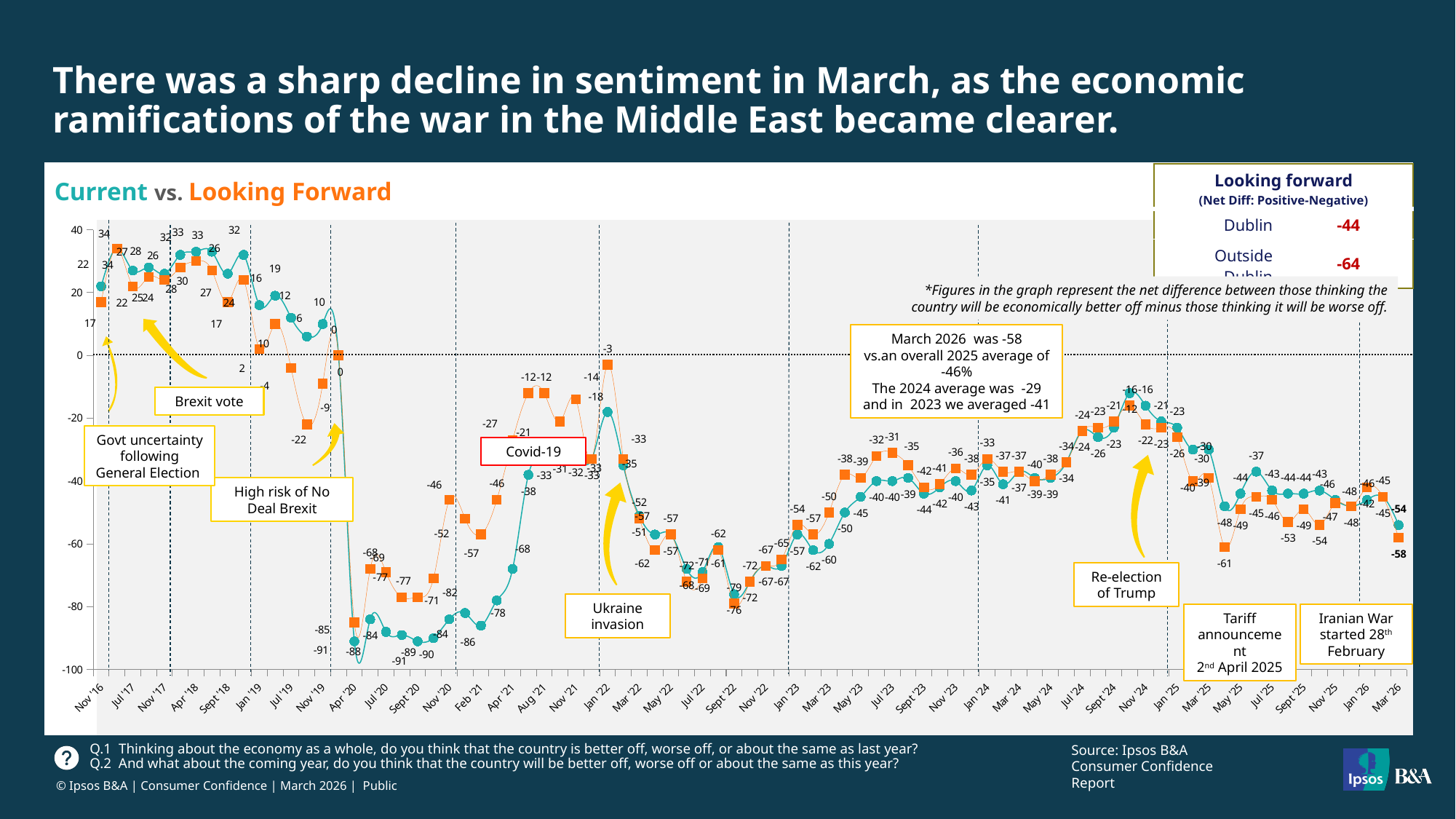
What kind of chart is shown on the slide? line chart Is the Current value for Apr '20 greater or less than -80? less What is the Current value for Mar '26? -54 What is the difference between the Current and Looking Forward values in Mar '26? 4 Which colour is used for the Looking Forward series? orange How many series does the chart plot? 2 In Jan '22, which is higher: the Current value or the Looking Forward value? Looking Forward What is the Looking Forward value for Mar '26? -58 What is the lowest Looking Forward value shown on the chart? -85 From Sept '24 to Mar '26, do the Looking Forward values generally rise or fall? fall What is the Looking Forward value for Jan '22? -3 What is the Looking Forward net difference for Dublin shown in the box at the top right? -44